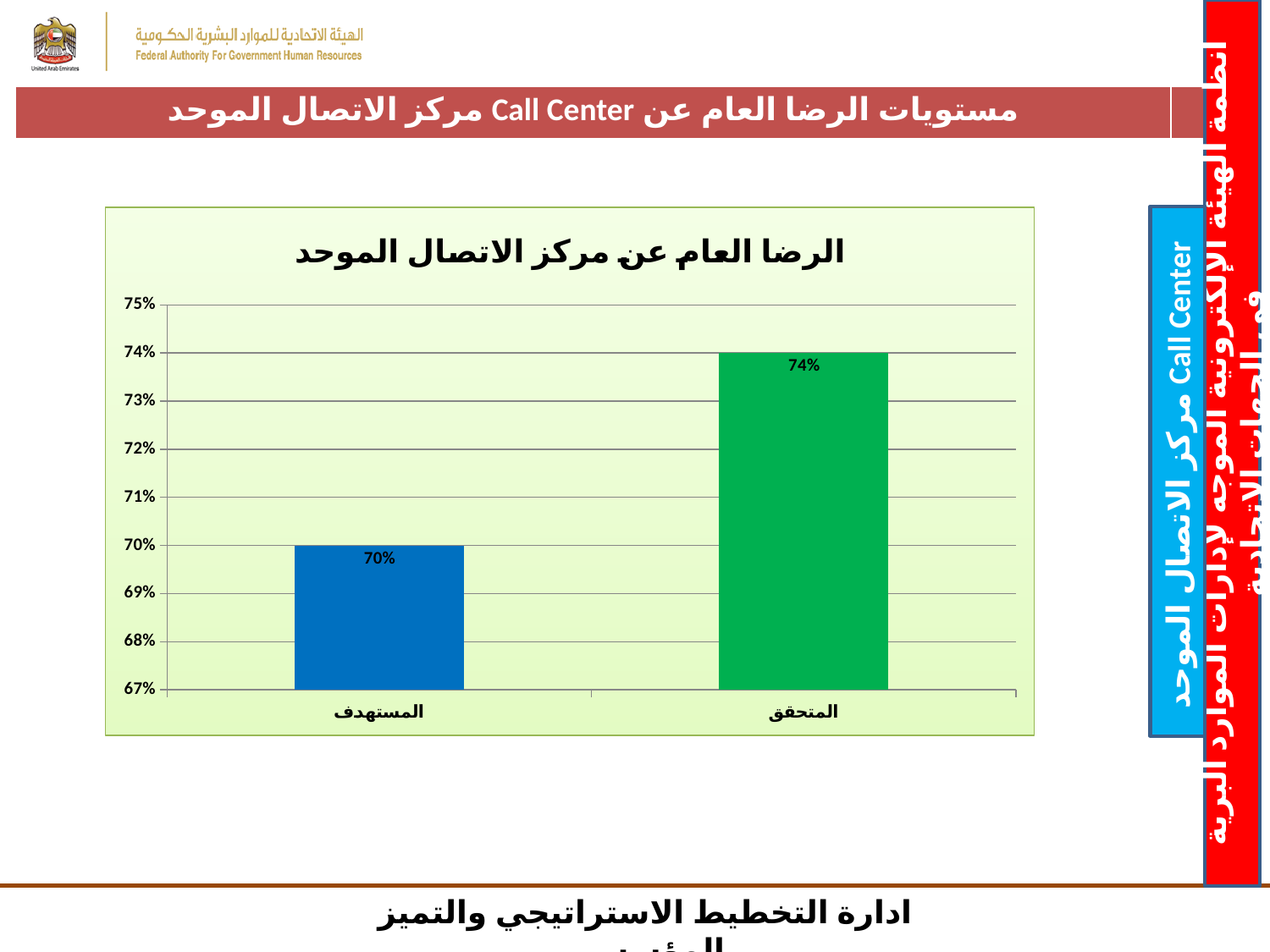
What colour is the bar for المتحقق? green What is the title of the chart? الرضا العام عن مركز الاتصال الموحد Which is larger, the value for المستهدف or the value for المتحقق? المتحقق What kind of chart is shown on the slide? bar chart Is the value for المستهدف greater or less than 73%? less What is the difference between the values for المتحقق and المستهدف? 4% Which category has the lowest value? المستهدف Which category has the highest value? المتحقق How many categories are shown on the x axis? 2 What is the value for المتحقق? 74% What is the value for المستهدف? 70% Is the value for المتحقق greater or less than 72%? greater